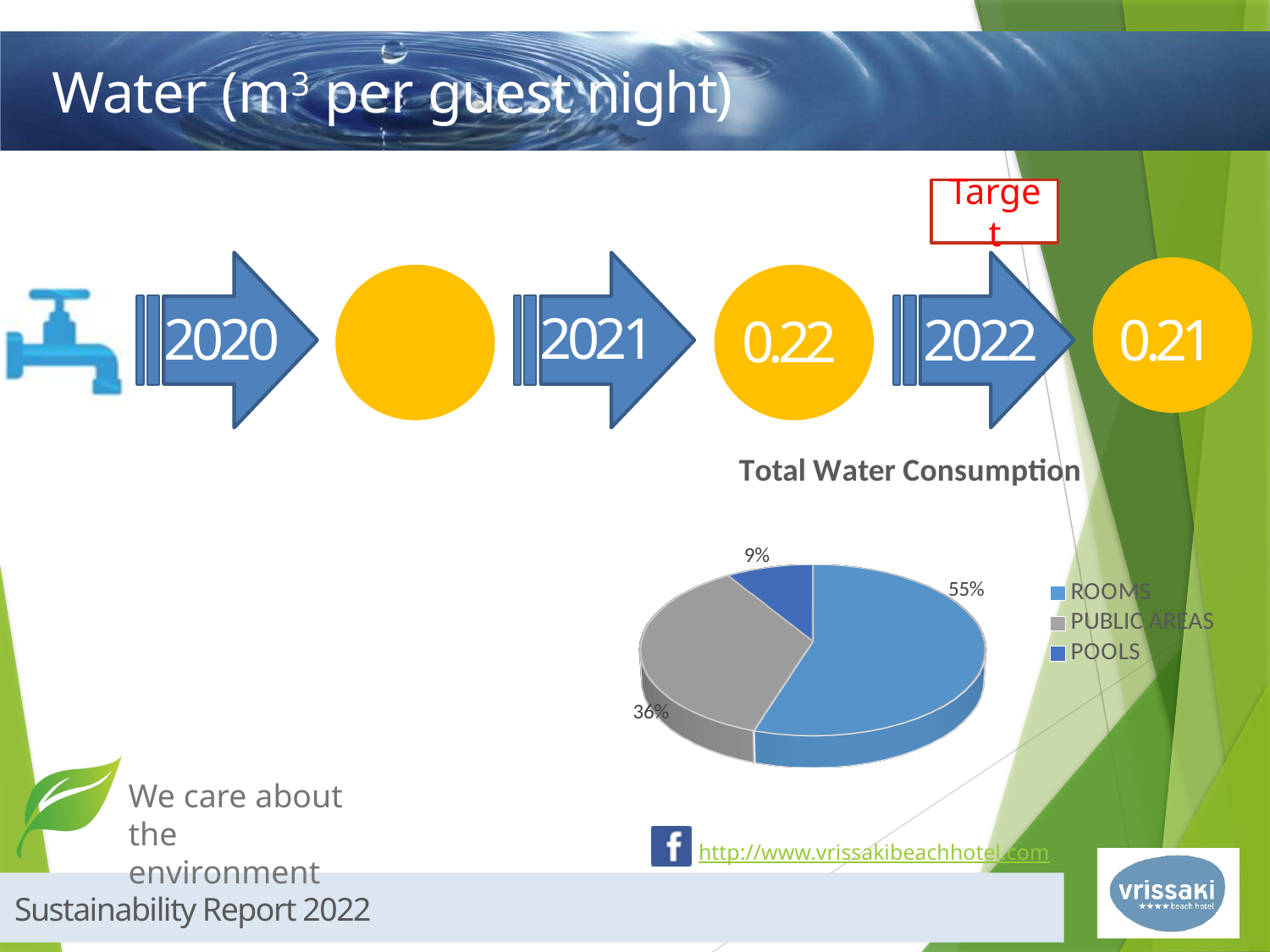
How many entries does the legend of the Total Water Consumption chart list? 3 What share of Total Water Consumption is attributed to PUBLIC AREAS? 36% How many slices does the Total Water Consumption pie chart have? 3 In the Total Water Consumption chart, which is larger: the share for PUBLIC AREAS or the share for POOLS? PUBLIC AREAS What share of Total Water Consumption is attributed to POOLS? 9% What colour is the ROOMS slice in the Total Water Consumption chart? Blue Which category accounts for the smallest share of Total Water Consumption? POOLS What kind of chart is used to show Total Water Consumption? Pie chart What is the title of the chart on the slide? Total Water Consumption How many percentage points larger is the ROOMS share than the PUBLIC AREAS share in the Total Water Consumption chart? 19 What share of Total Water Consumption is attributed to ROOMS? 55% Which category accounts for the largest share of Total Water Consumption? ROOMS